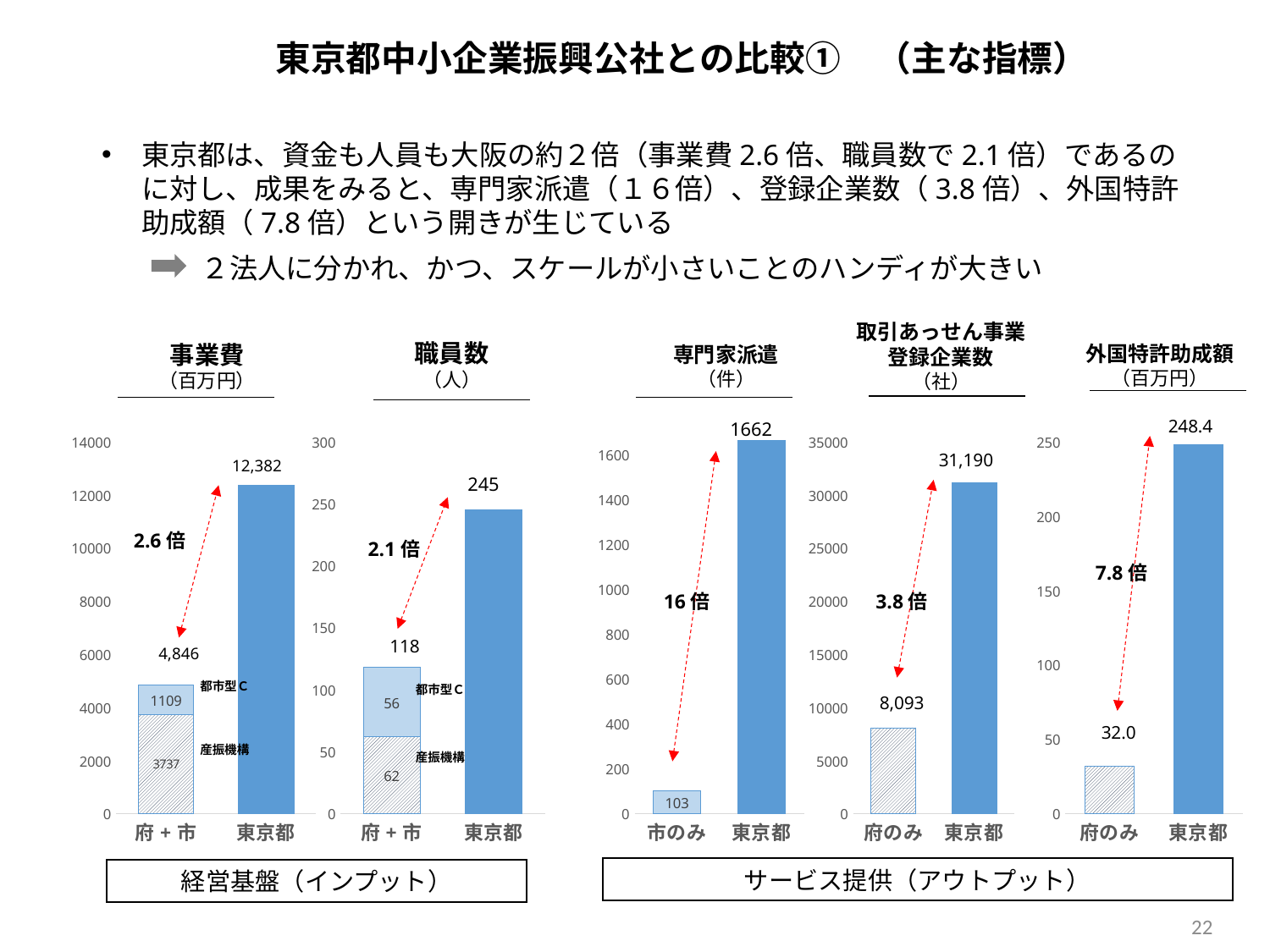
How many charts are shown on the slide? 5 In the 事業費 chart, what is the 産振機構 portion of the 府＋市 bar? 3737 In the 専門家派遣 chart, which category is highest? 東京都 What kind of chart is the 外国特許助成額 chart? bar chart In the 取引あっせん事業登録企業数 chart, what is the value for 府のみ? 8,093 In the 外国特許助成額 chart, what is the difference between 東京都 and 府のみ? 216.4 In the 専門家派遣 chart, what is the value for 市のみ? 103 In the 事業費 chart, what is the value for 東京都? 12,382 In the 事業費 chart, what is the total of the stacked 府＋市 bar? 4,846 In the 職員数 chart, what is the difference between 東京都 and 府＋市? 127 In the 職員数 chart, what is the 都市型C portion of the 府＋市 bar? 56 In the 取引あっせん事業登録企業数 chart, is the value for 東京都 greater or less than 30000? greater